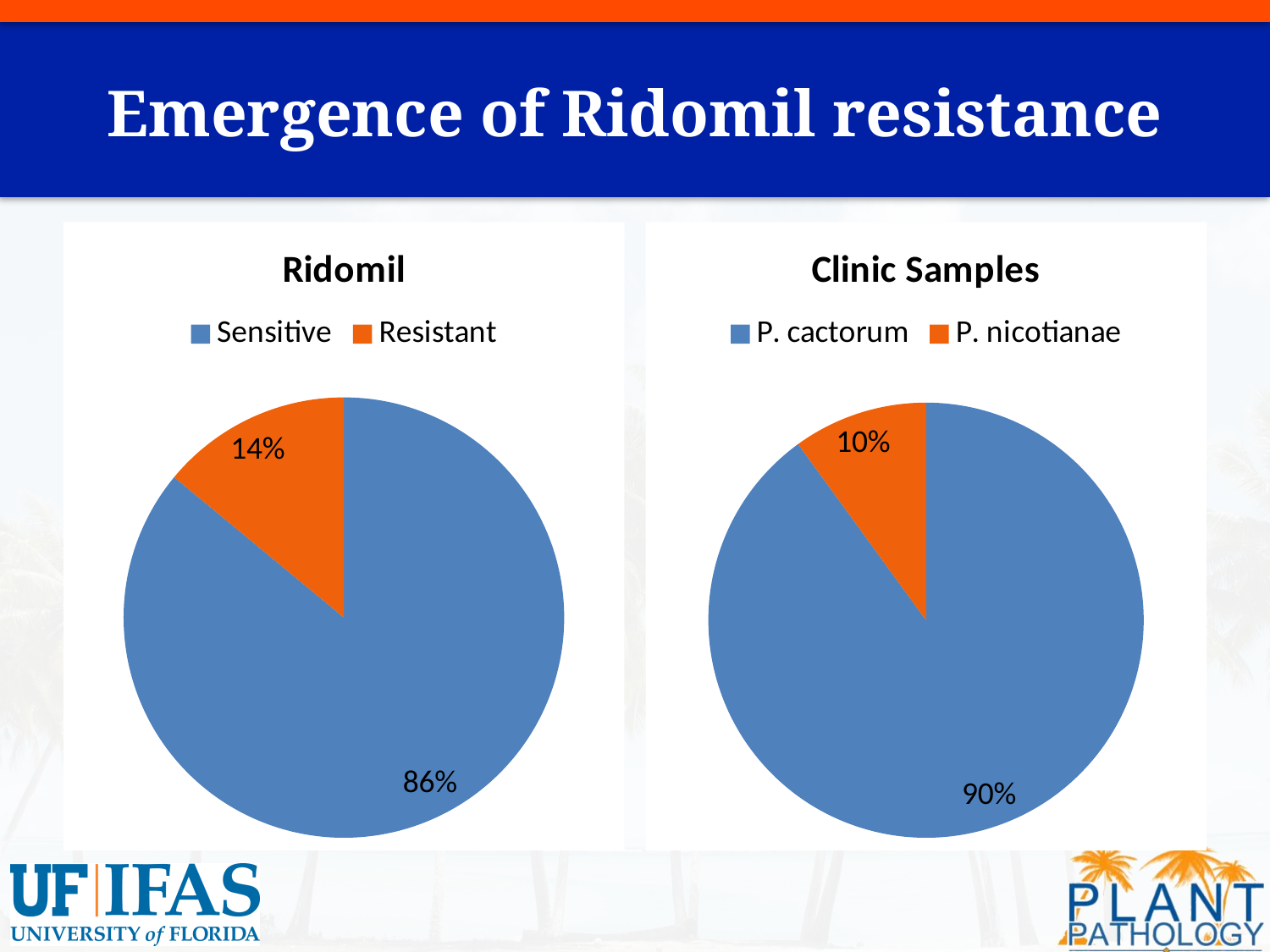
How many categories does the legend of the Ridomil chart list? 2 What kind of chart is the Clinic Samples chart? Pie chart In the Ridomil chart, what is the difference between the Sensitive and Resistant shares? 72% In the Ridomil chart, which category has the largest slice? Sensitive What is the title of the chart on the right side of the slide? Clinic Samples In the Clinic Samples chart, what is the difference between the P. cactorum and P. nicotianae shares? 80% In the Clinic Samples chart, what share of the pie is P. nicotianae? 10% In the Ridomil chart, which is larger, Sensitive or Resistant? Sensitive In the Ridomil chart, what share of the pie is Sensitive? 86% In the Clinic Samples chart, which category has the smallest slice? P. nicotianae In the Ridomil chart, what share of the pie is Resistant? 14%